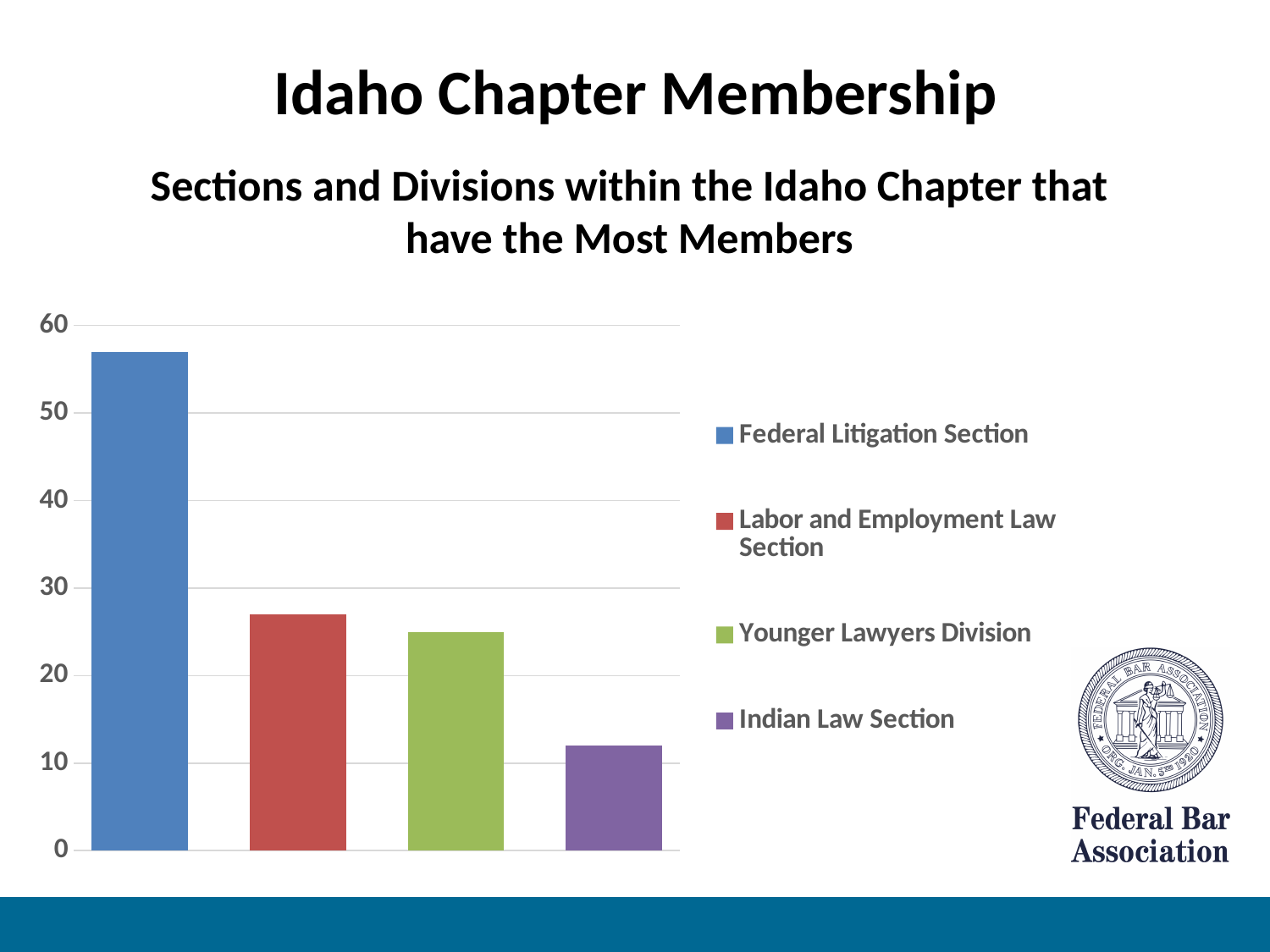
Which section or division has the lowest number of members? Indian Law Section Do the bar values rise or fall from left to right across the chart? fall Is the value for the Labor and Employment Law Section greater or less than 30? less Is the value for the Indian Law Section greater or less than 20? less What kind of chart is shown on the slide? bar chart What colour is the bar for the Younger Lawyers Division? green Is the value for the Federal Litigation Section greater or less than 50? greater How many bars are plotted in the chart? 4 Which section or division has the highest number of members? Federal Litigation Section How many entries does the chart's legend list? 4 Which has more members, the Federal Litigation Section or the Indian Law Section? Federal Litigation Section